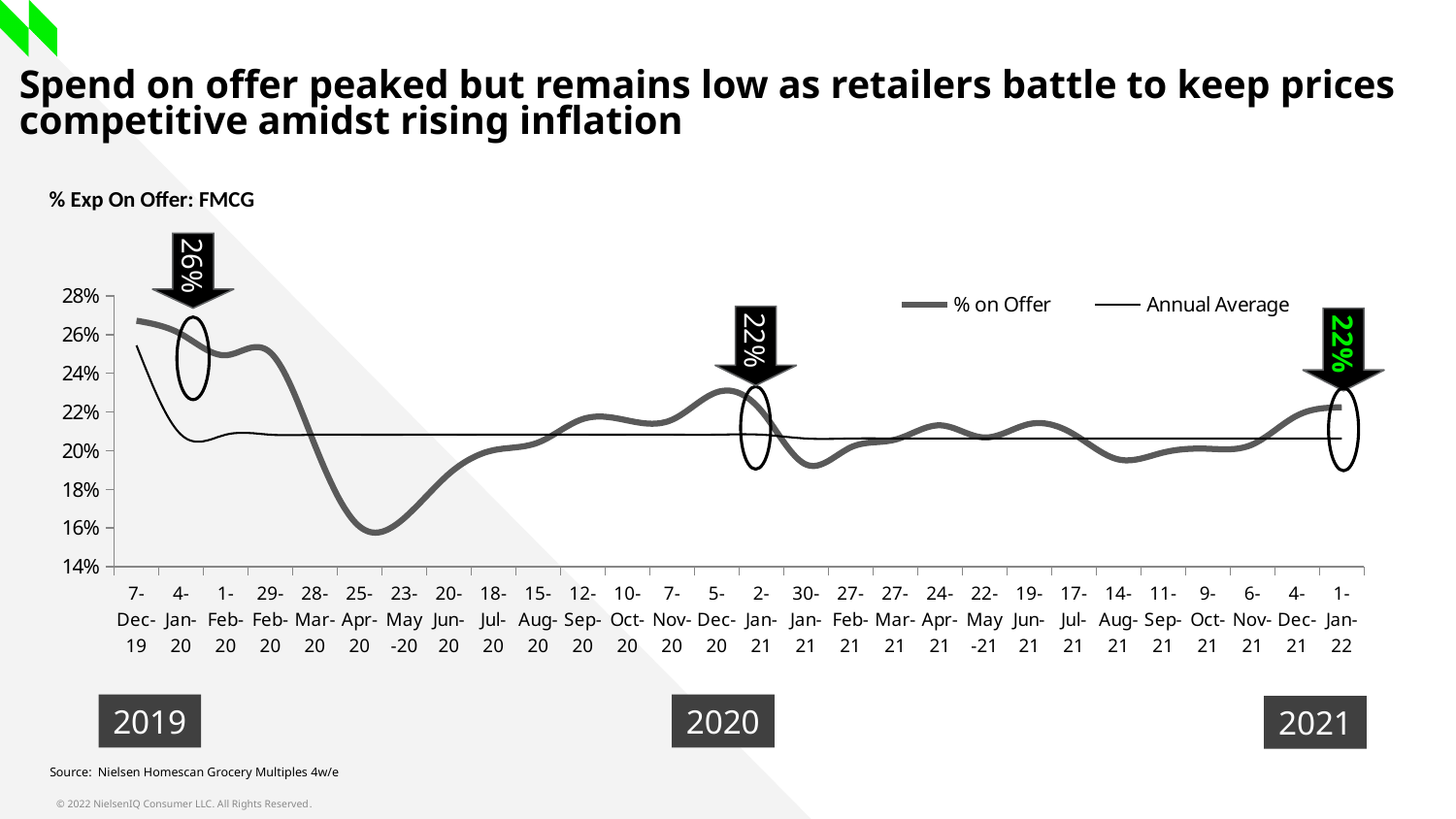
What value does the annotation arrow at 1-Jan-22 show for % on Offer? 22% Which is larger, the % on Offer value at 7-Dec-19 or at 25-Apr-20? 7-Dec-19 What are the two series named in the legend? % on Offer and Annual Average At which x-axis date does the % on Offer line reach its lowest point? 25-Apr-20 What kind of chart is shown on the slide? line chart What value does the annotation arrow near 2-Jan-21 show for % on Offer? 22% What value does the annotation arrow near the start of 2020 show for % on Offer? 26% How many date labels are shown on the x axis? 28 Is the % on Offer value at 25-Apr-20 greater or less than 18%? less Does the % on Offer line rise or fall between 7-Dec-19 and 25-Apr-20? fall How many series does the legend list? 2 What is the title of the chart? % Exp On Offer: FMCG